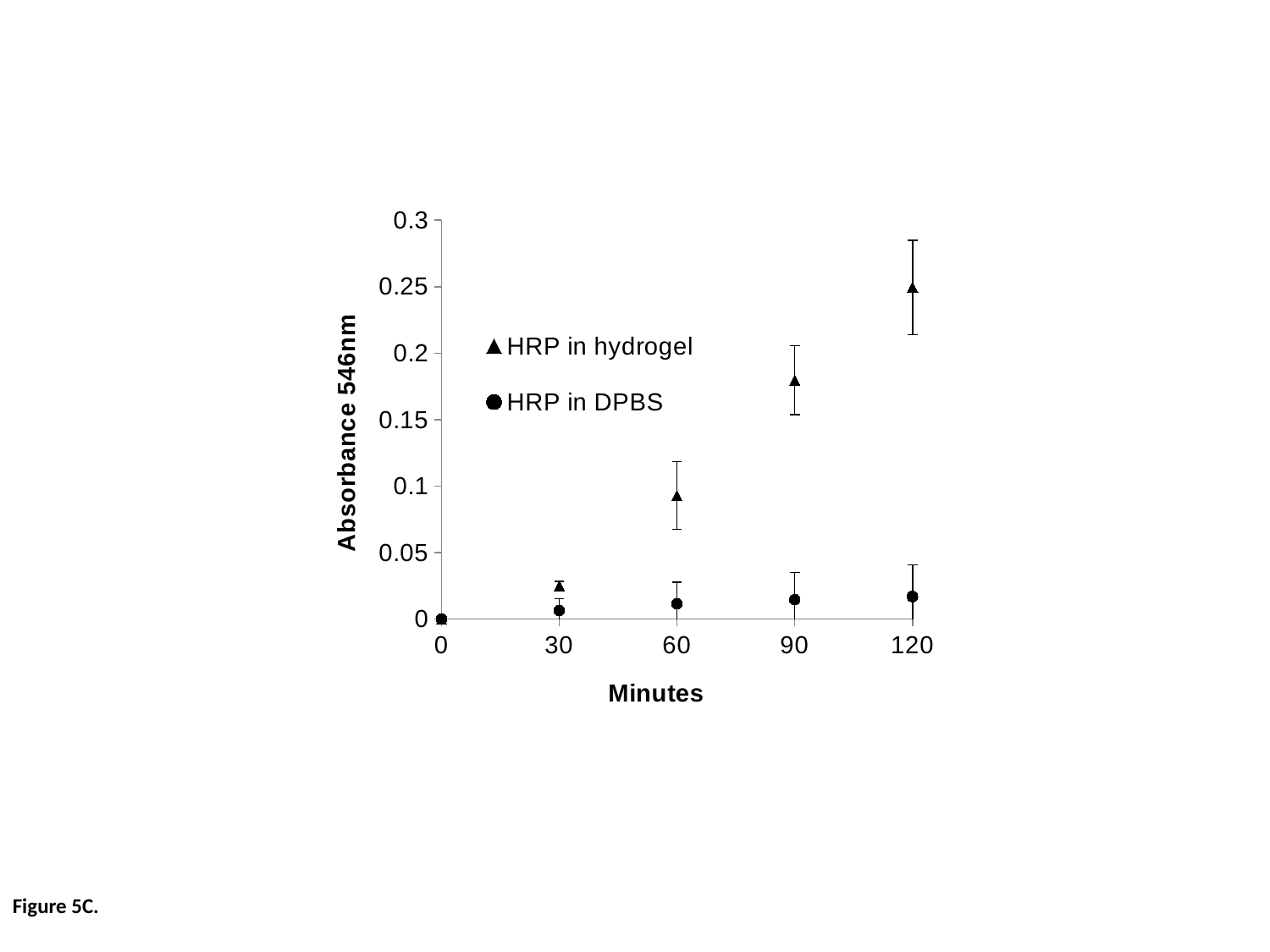
At 120 minutes, which series has the larger absorbance, HRP in hydrogel or HRP in DPBS? HRP in hydrogel What is the label of the y axis? Absorbance 546nm Does the absorbance for HRP in hydrogel rise or fall as minutes increase? rise Which marker shape is used for the HRP in DPBS series? circle At which time point does HRP in hydrogel reach its highest absorbance? 120 How many series does the legend list? 2 What kind of chart is shown on the slide? scatter chart Is the value for HRP in hydrogel at 120 minutes greater or less than 0.2? greater Is the value for HRP in DPBS at 120 minutes greater or less than 0.05? less Is the value for HRP in hydrogel at 90 minutes greater or less than 0.15? greater How many time points are plotted along the x axis? 5